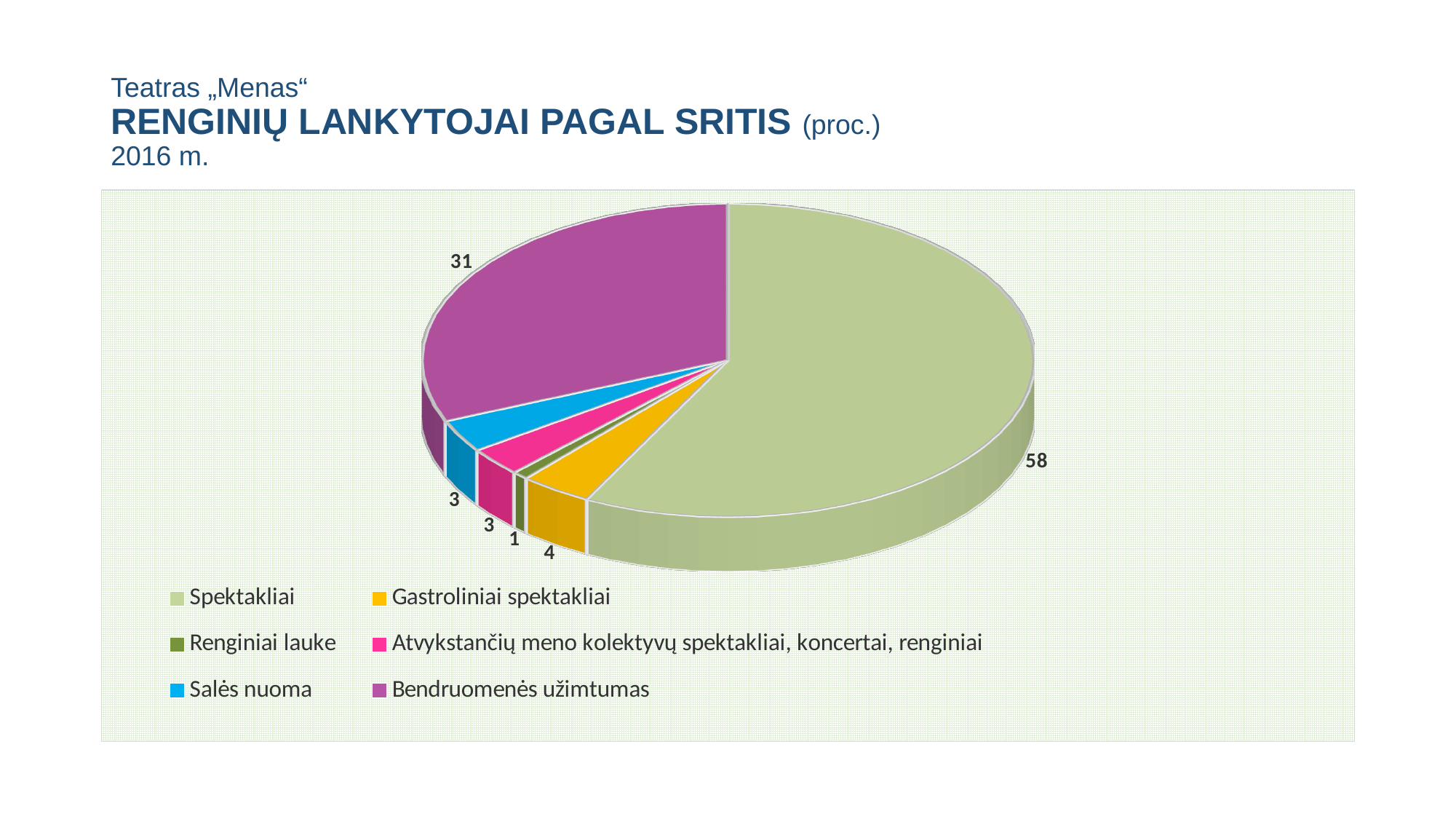
What colour is the Bendruomenės užimtumas slice? Purple What kind of chart is shown on the slide? Pie chart What is the difference between the values for Spektakliai and Bendruomenės užimtumas? 27 Which category has the largest slice? Spektakliai Which category has the smallest slice? Renginiai lauke What is the value for Renginiai lauke? 1 Which is larger, Gastroliniai spektakliai or Salės nuoma? Gastroliniai spektakliai What is the value for Gastroliniai spektakliai? 4 What is the value for Salės nuoma? 3 What is the value for Bendruomenės užimtumas? 31 What is the value for Spektakliai? 58 How many categories does the pie chart show? 6